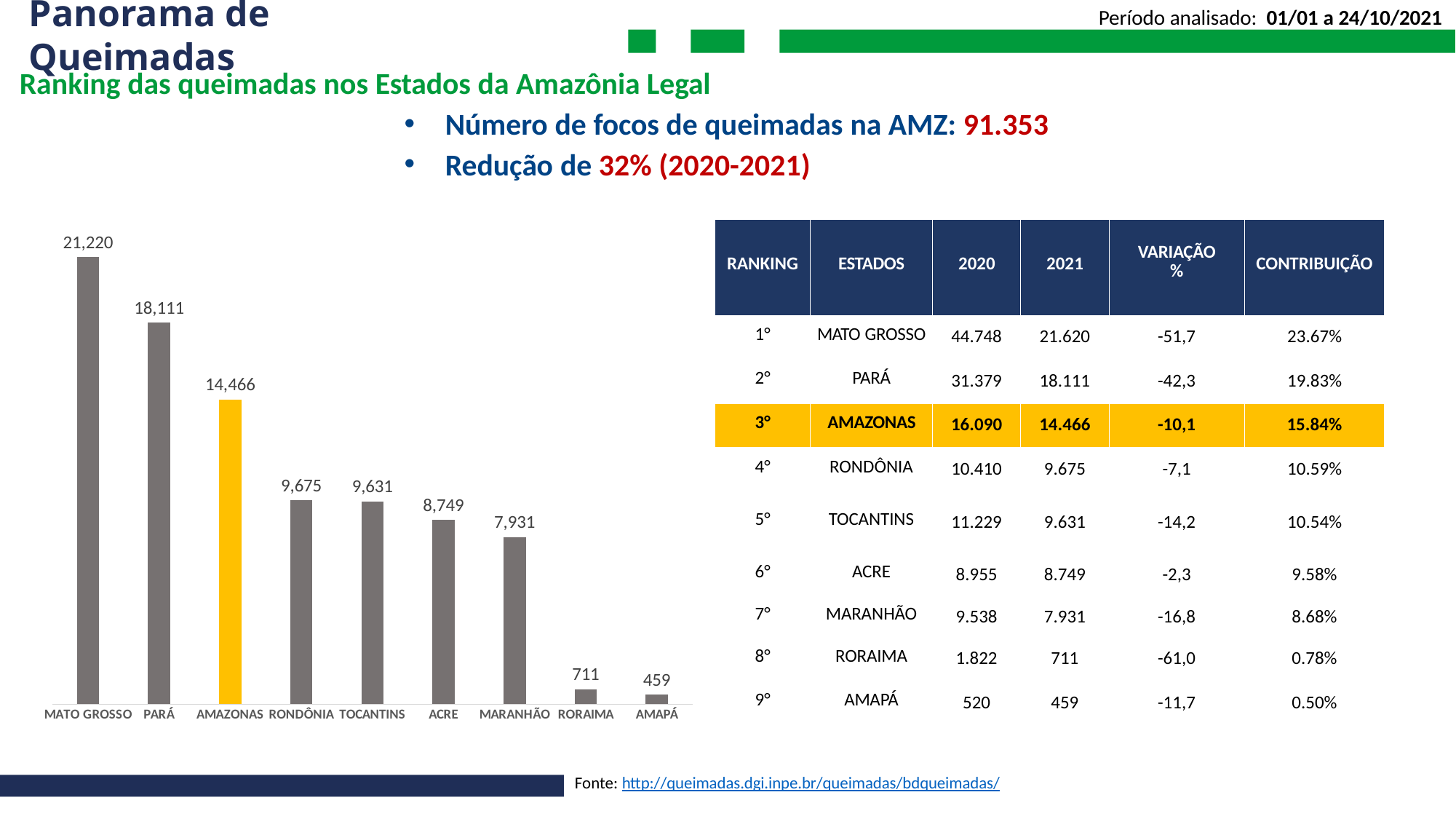
Which has a larger value in the bar chart, Acre or Maranhão? Acre What type of chart is shown on the left of the slide? Bar chart Do the bar values rise or fall from left to right across the states? Fall What is the difference between the bar values for Pará and Amazonas? 3,645 What value does the bar chart show for Mato Grosso? 21,220 How many states are plotted in the bar chart? 9 What value does the bar chart show for Amazonas? 14,466 Which state has the lowest bar in the chart? Amapá Which state's bar is highlighted in yellow in the chart? Amazonas What is the difference between the bar values for Roraima and Amapá? 252 Which state has the highest bar in the chart? Mato Grosso What value does the bar chart show for Roraima? 711